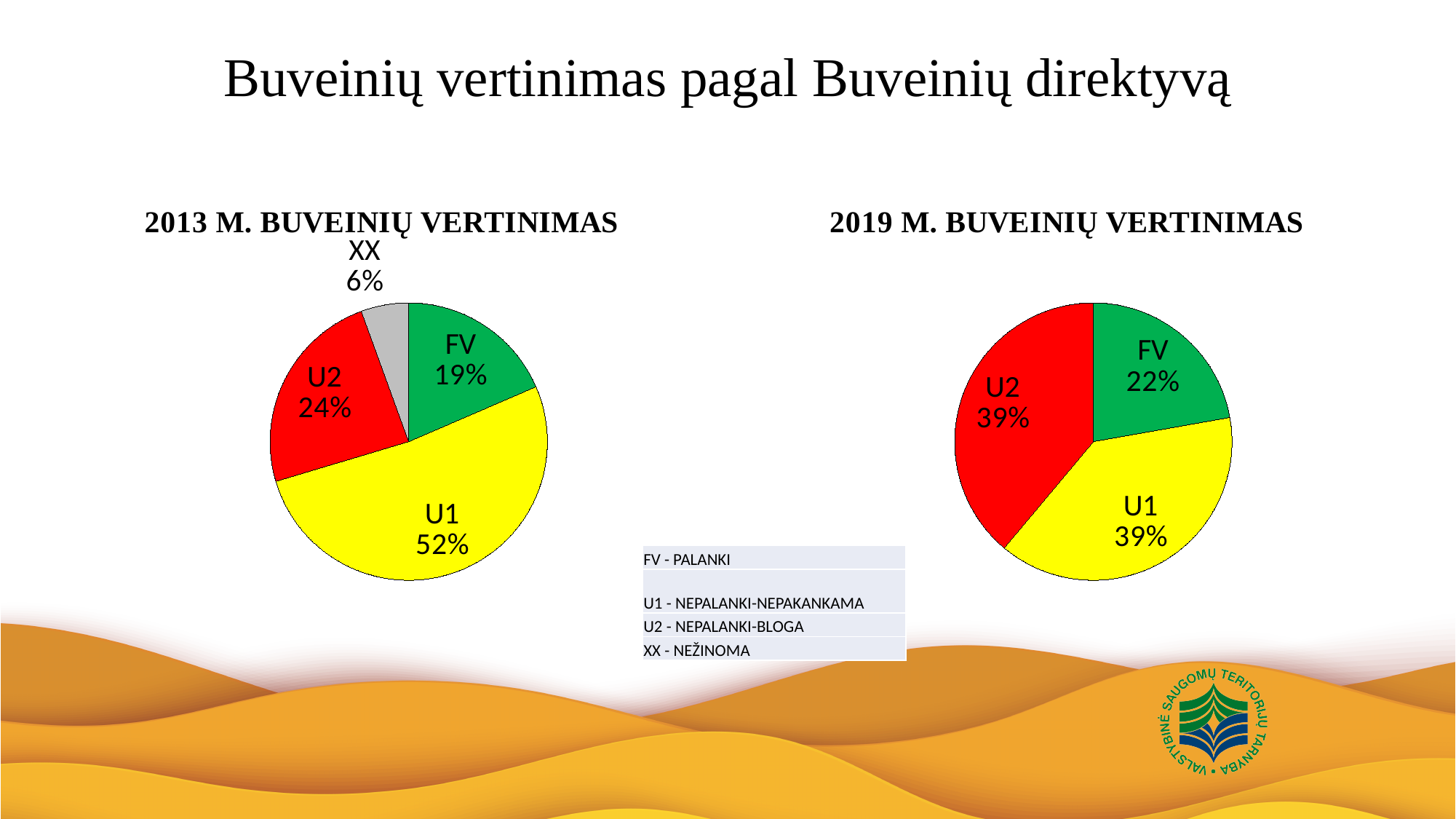
In the 2013 M. BUVEINIŲ VERTINIMAS chart, which is larger, FV or U2? U2 How many slices does the 2013 M. BUVEINIŲ VERTINIMAS chart have? 4 In the 2013 M. BUVEINIŲ VERTINIMAS chart, what share does U1 have? 52% In the 2013 M. BUVEINIŲ VERTINIMAS chart, what is the difference between the U1 and U2 shares? 28% In the 2013 M. BUVEINIŲ VERTINIMAS chart, what share does XX have? 6% In the 2013 M. BUVEINIŲ VERTINIMAS chart, which category has the largest slice? U1 In the 2019 M. BUVEINIŲ VERTINIMAS chart, which category has the smallest slice? FV In the 2019 M. BUVEINIŲ VERTINIMAS chart, what share does U2 have? 39% In the 2013 M. BUVEINIŲ VERTINIMAS chart, which category has the smallest slice? XX What type of chart is the 2019 M. BUVEINIŲ VERTINIMAS chart? Pie chart How many slices does the 2019 M. BUVEINIŲ VERTINIMAS chart have? 3